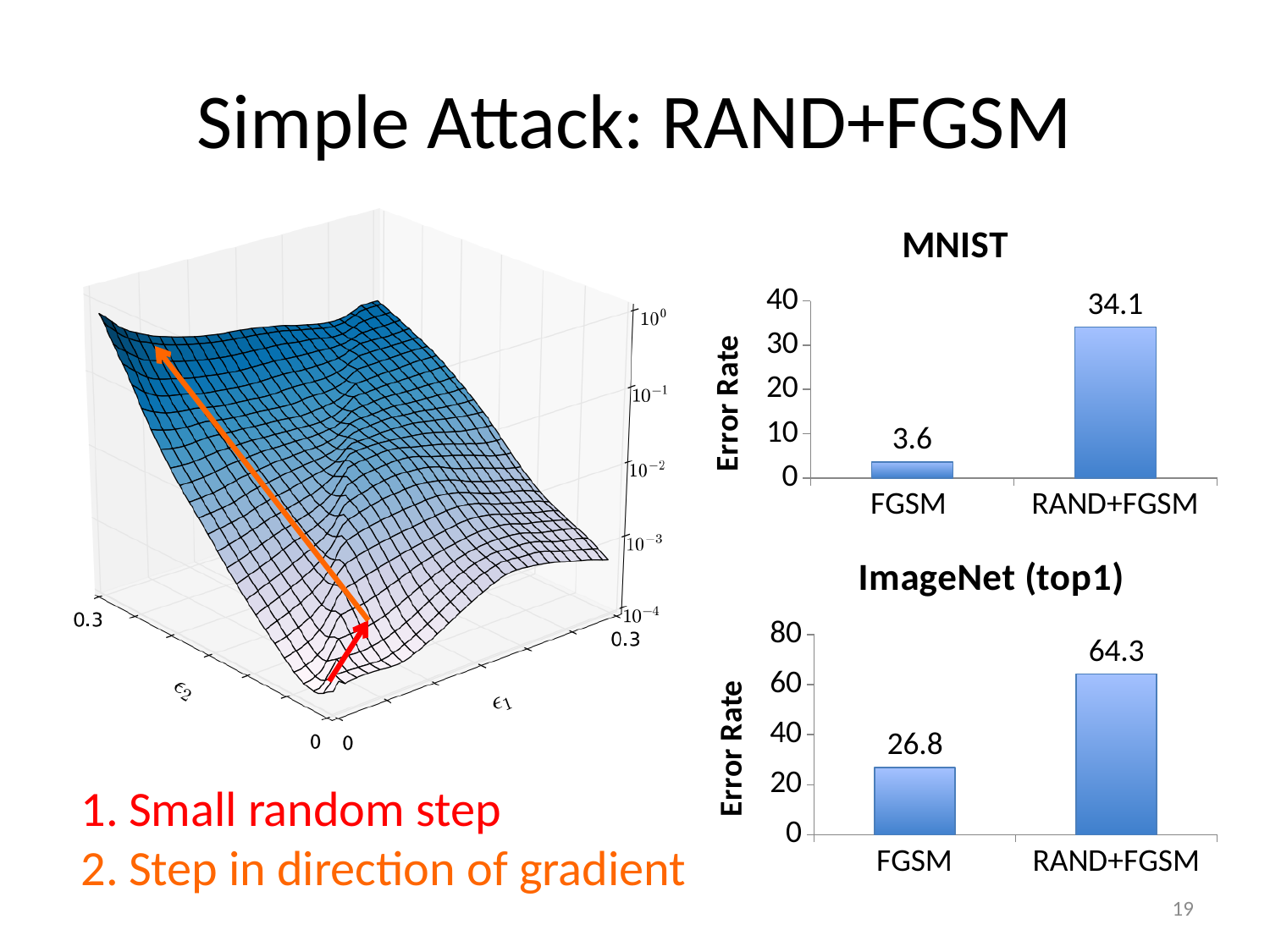
In the ImageNet (top1) chart, is the error rate for RAND+FGSM greater or less than 60? greater In the ImageNet (top1) chart, what is the error rate for FGSM? 26.8 How many categories are shown in the MNIST chart? 2 In the ImageNet (top1) chart, which attack has the lower error rate? FGSM In the ImageNet (top1) chart, what is the difference in error rate between RAND+FGSM and FGSM? 37.5 In the MNIST chart, what is the error rate for RAND+FGSM? 34.1 In the MNIST chart, what is the difference in error rate between RAND+FGSM and FGSM? 30.5 In the MNIST chart, which attack has the higher error rate? RAND+FGSM In the ImageNet (top1) chart, what is the error rate for RAND+FGSM? 64.3 In the MNIST chart, what is the error rate for FGSM? 3.6 What type of chart is the ImageNet (top1) chart? Bar chart Is the FGSM error rate in the ImageNet (top1) chart greater or less than the RAND+FGSM error rate in the MNIST chart? greater